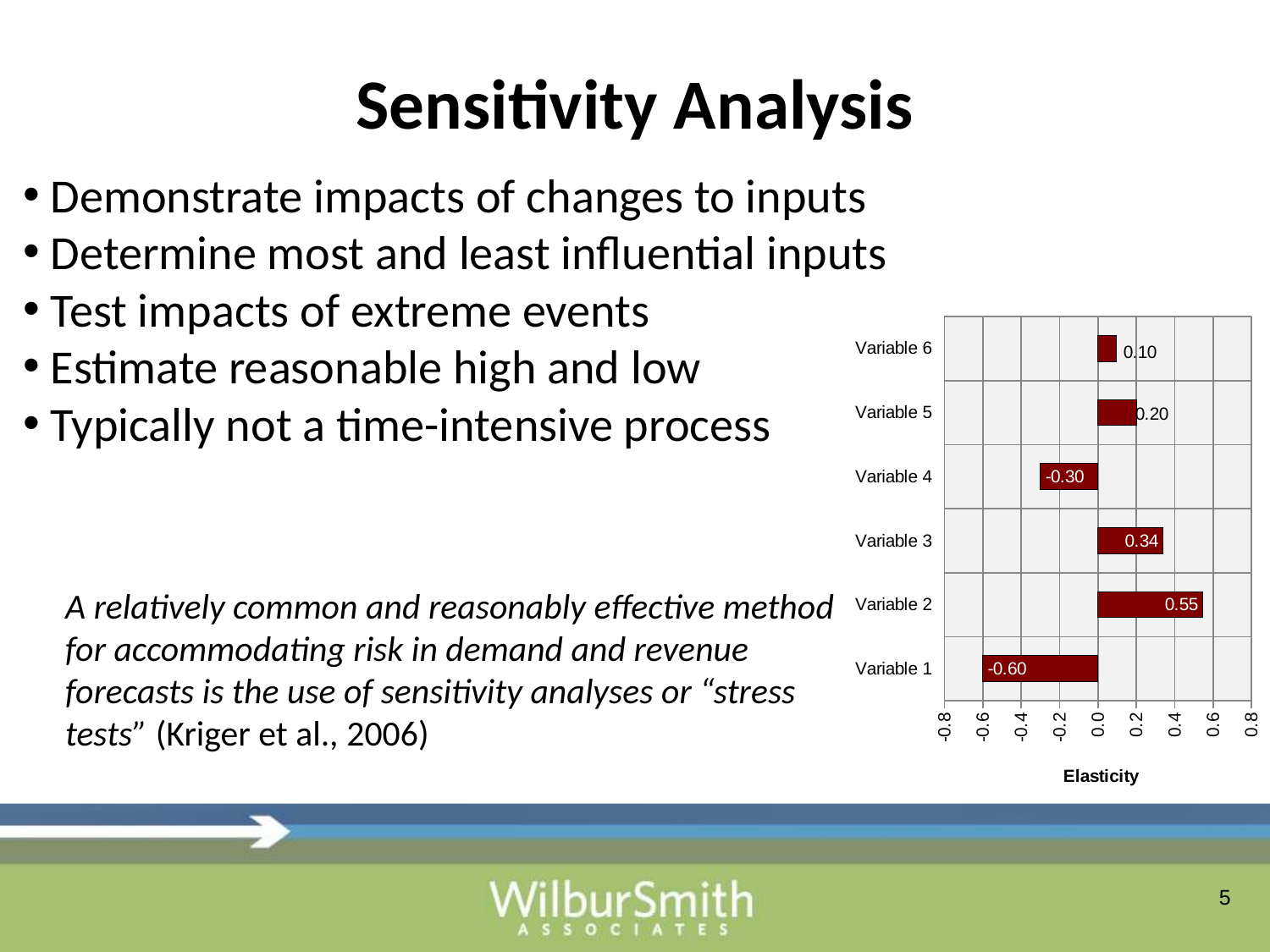
What is the difference between the elasticity values of Variable 5 and Variable 6? 0.10 What is the difference between the elasticity values of Variable 2 and Variable 3? 0.21 What is the elasticity value for Variable 2? 0.55 Which variable has the lowest elasticity value? Variable 1 Which has a larger elasticity value, Variable 3 or Variable 5? Variable 3 What is the elasticity value for Variable 1? -0.60 What is the title of the horizontal axis of the chart? Elasticity How many variables are plotted in the chart? 6 What is the elasticity value for Variable 4? -0.30 Which variable has the highest elasticity value? Variable 2 What kind of chart is shown on the slide? Bar chart What is the elasticity value for Variable 6? 0.10